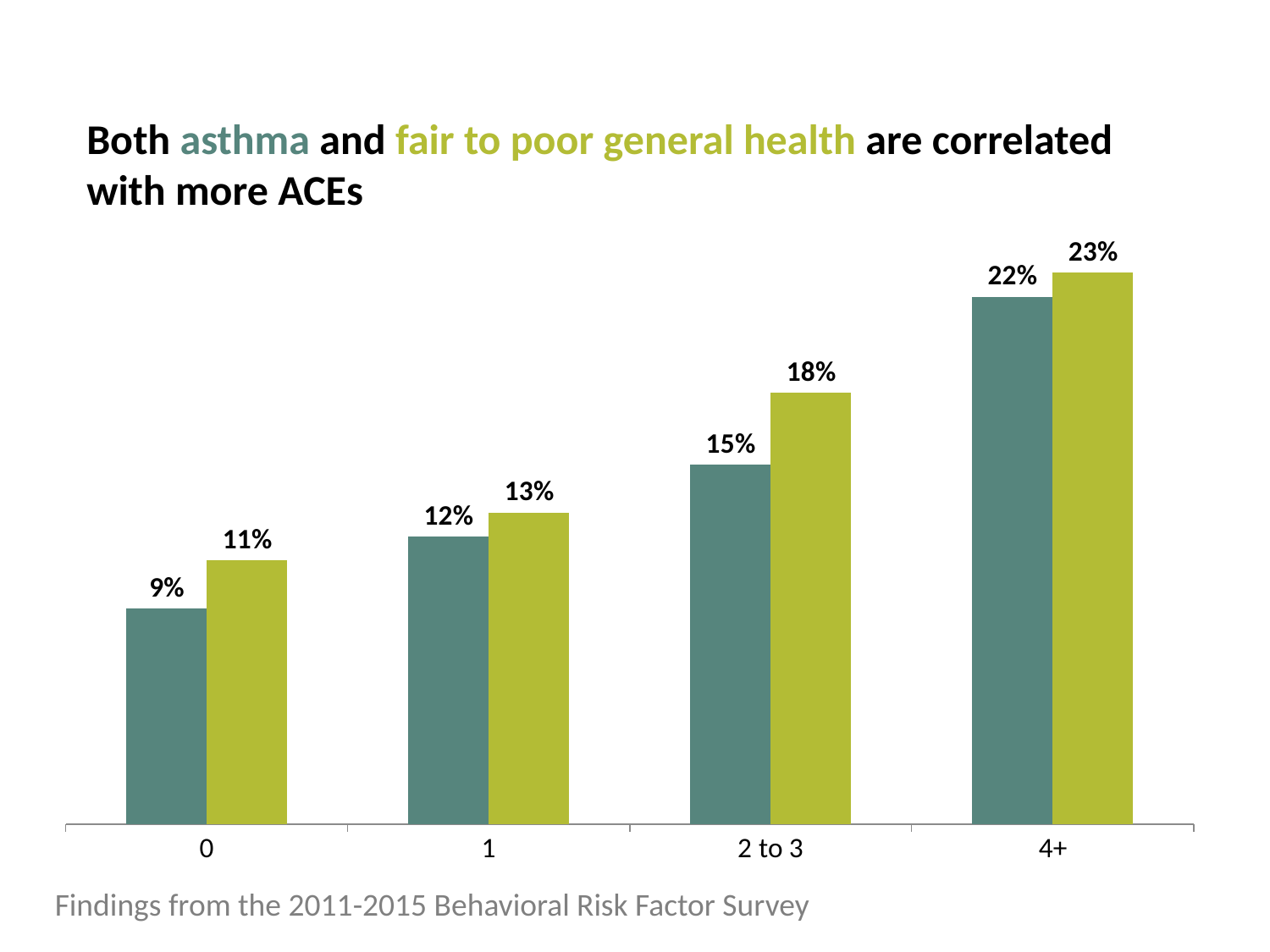
What kind of chart is shown on the slide? bar chart How many ACEs categories are shown on the x axis? 4 What is the difference between the fair to poor general health and asthma values for the 2 to 3 ACEs category? 3% What is the asthma (teal bar) value for the 4+ ACEs category? 22% Do the asthma (teal bar) values rise or fall as the number of ACEs increases along the x axis? rise Which ACEs category has the lowest asthma (teal bar) value? 0 What is the asthma (teal bar) value for the 0 ACEs category? 9% What is the fair to poor general health (green bar) value for the 2 to 3 ACEs category? 18% What is the fair to poor general health (green bar) value for the 1 ACE category? 13% What is the difference between the asthma values for the 4+ and 0 ACEs categories? 13% Which ACEs category has the highest fair to poor general health (green bar) value? 4+ Which is larger for the 0 ACEs category: the asthma value or the fair to poor general health value? fair to poor general health